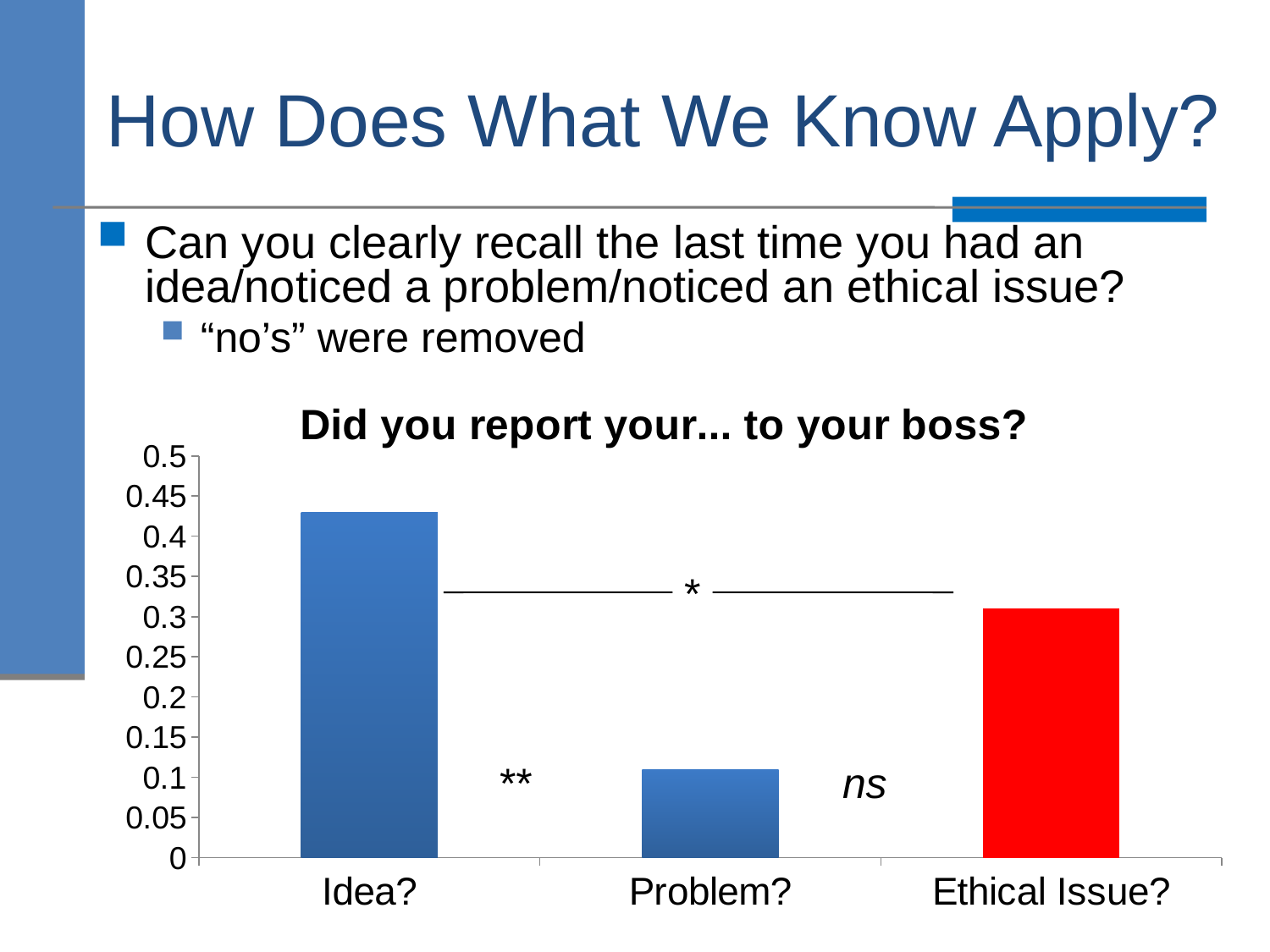
Is the value for Ethical Issue? greater or less than 0.25? greater Is the value for Problem? greater or less than 0.15? less Does the value fall or rise from Idea? to Problem? fall Which category has the lowest bar? Problem? Which category has the highest bar? Idea? Which is larger, the value for Problem? or the value for Ethical Issue? Ethical Issue? How many categories are shown on the x axis of the chart? 3 What kind of chart is shown on the slide? bar chart What colour is the bar for Ethical Issue? red Which is larger, the value for Idea? or the value for Ethical Issue? Idea? What is the title of the chart? Did you report your... to your boss? Is the value for Idea? greater or less than 0.4? greater